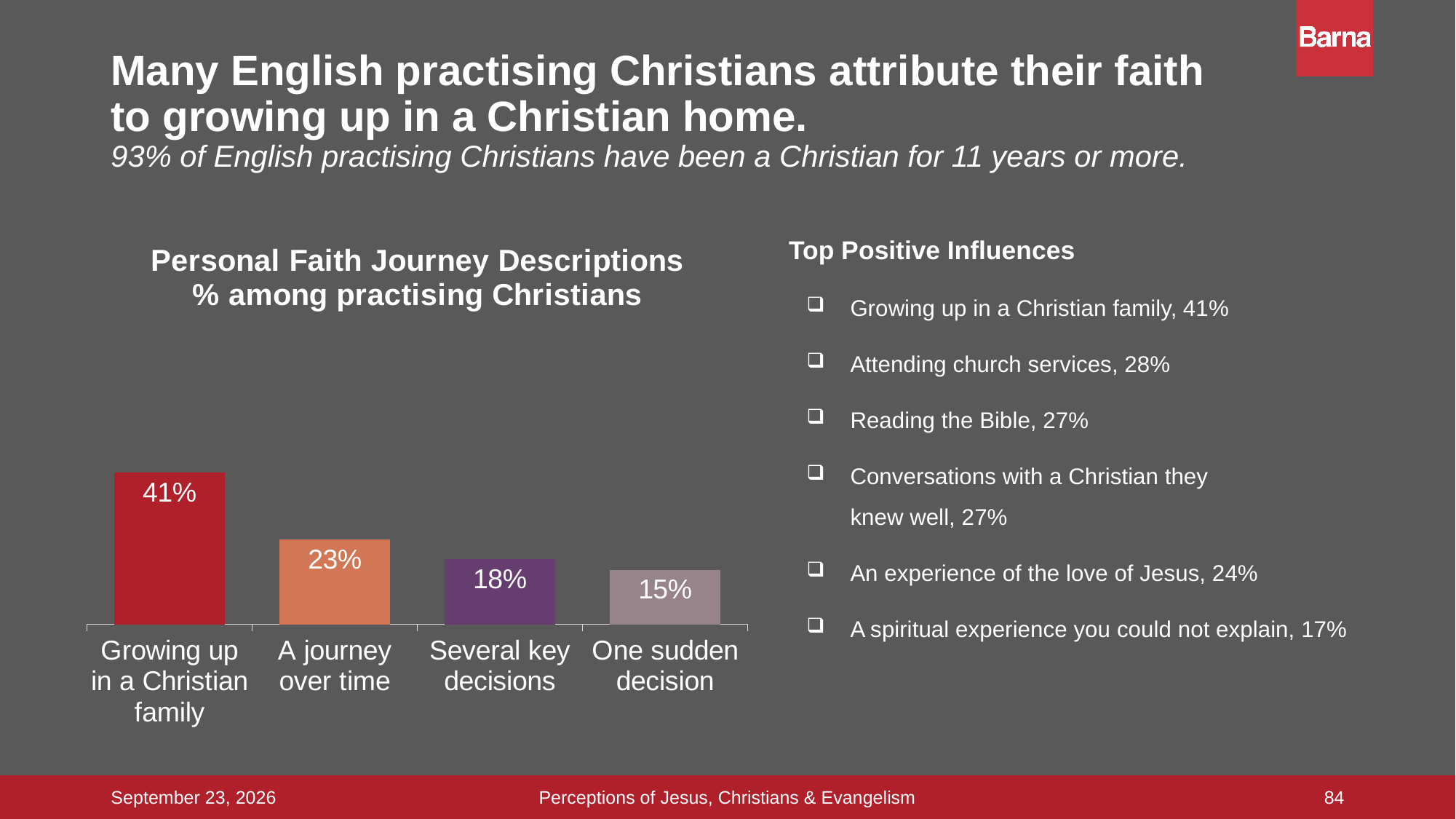
What kind of chart is shown on the slide? Bar chart What is the value for 'Several key decisions'? 18% Which category has the highest value? Growing up in a Christian family What is the difference between 'Several key decisions' and 'One sudden decision'? 3% What is the difference between 'Growing up in a Christian family' and 'A journey over time'? 18% Which category has the lowest value? One sudden decision What is the title of the chart? Personal Faith Journey Descriptions % among practising Christians How many categories are shown in the chart? 4 What is the value for 'A journey over time'? 23% What is the value for 'Growing up in a Christian family'? 41% What is the value for 'One sudden decision'? 15% Which is larger, 'A journey over time' or 'Several key decisions'? A journey over time